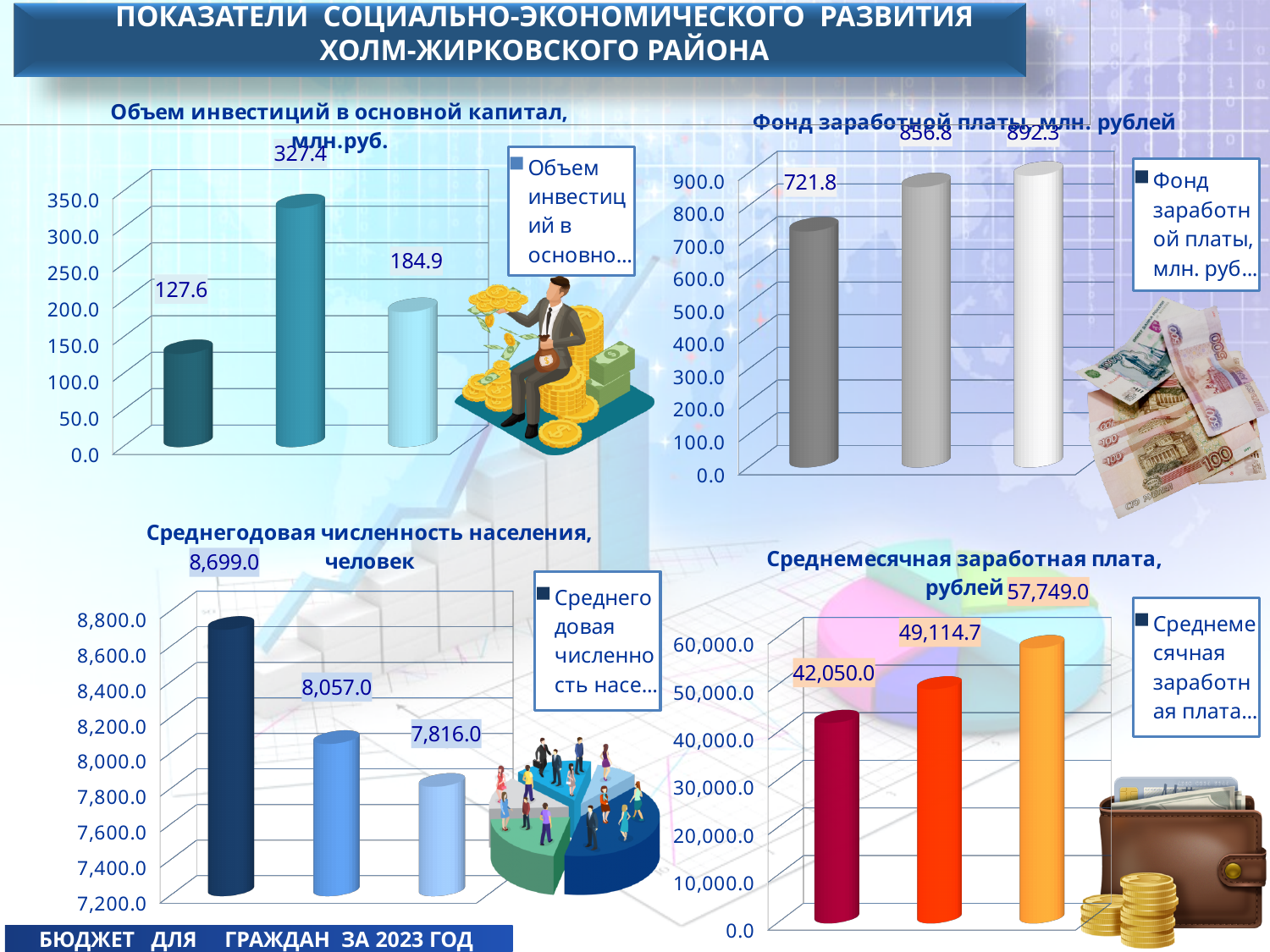
In the chart 'Фонд заработной платы, млн. рублей', do the values rise or fall from left to right? rise In the chart 'Объем инвестиций в основной капитал, млн.руб.', what is the difference between the second bar and the first bar? 199.8 In the chart 'Среднегодовая численность населения, человек', what is the value of the first bar? 8,699.0 In the chart 'Среднегодовая численность населения, человек', do the values rise or fall from left to right? fall In the chart 'Фонд заработной платы, млн. рублей', what is the value of the third bar? 892.3 In the chart 'Среднемесячная заработная плата, рублей', which bar has the highest value? the third bar (57,749.0) In the chart 'Объем инвестиций в основной капитал, млн.руб.', what is the value of the second (middle) bar? 327.4 In the chart 'Объем инвестиций в основной капитал, млн.руб.', which bar has the lowest value? the first bar (127.6) In the chart 'Фонд заработной платы, млн. рублей', what is the difference between the third bar and the first bar? 170.5 In the chart 'Среднемесячная заработная плата, рублей', what is the difference between the third bar and the first bar? 15,699.0 What type of chart is 'Среднемесячная заработная плата, рублей'? bar chart In the chart 'Среднегодовая численность населения, человек', how many bars are plotted? 3